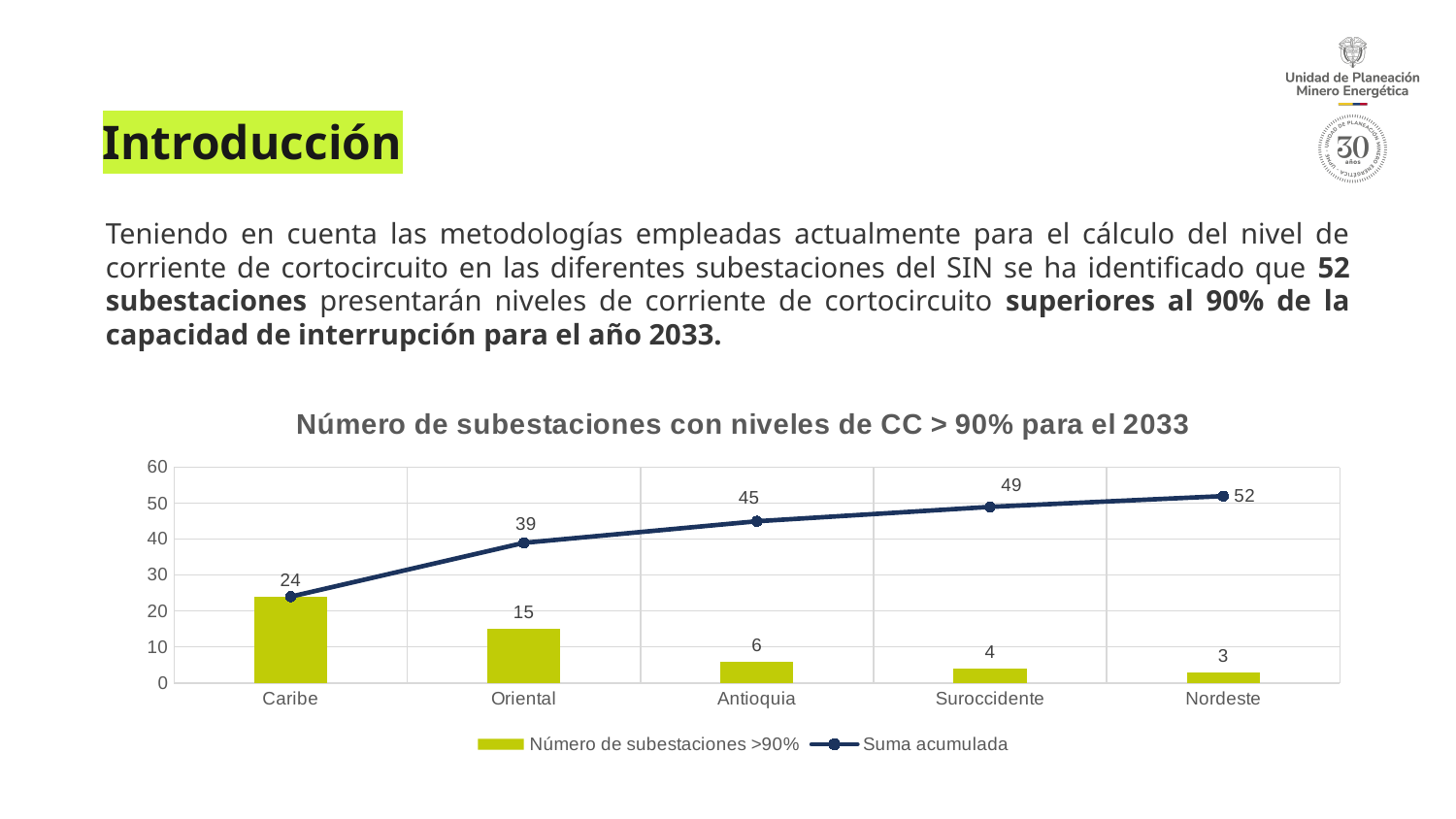
How many series does the legend list? 2 What kind of chart is this? Combined bar and line chart Does the Suma acumulada line rise or fall from Caribe to Nordeste? Rises What is the title of the chart? Número de subestaciones con niveles de CC > 90% para el 2033 What is the difference between the number of substations >90% for Caribe and Oriental? 9 What is the final cumulative sum value at Nordeste? 52 What is the number of substations >90% for Caribe? 24 How many regions are shown on the x axis? 5 What is the cumulative sum (Suma acumulada) value at Antioquia? 45 Which region has the highest number of substations >90%? Caribe Which is larger, the number of substations >90% for Antioquia or for Suroccidente? Antioquia Which region has the lowest number of substations >90%? Nordeste